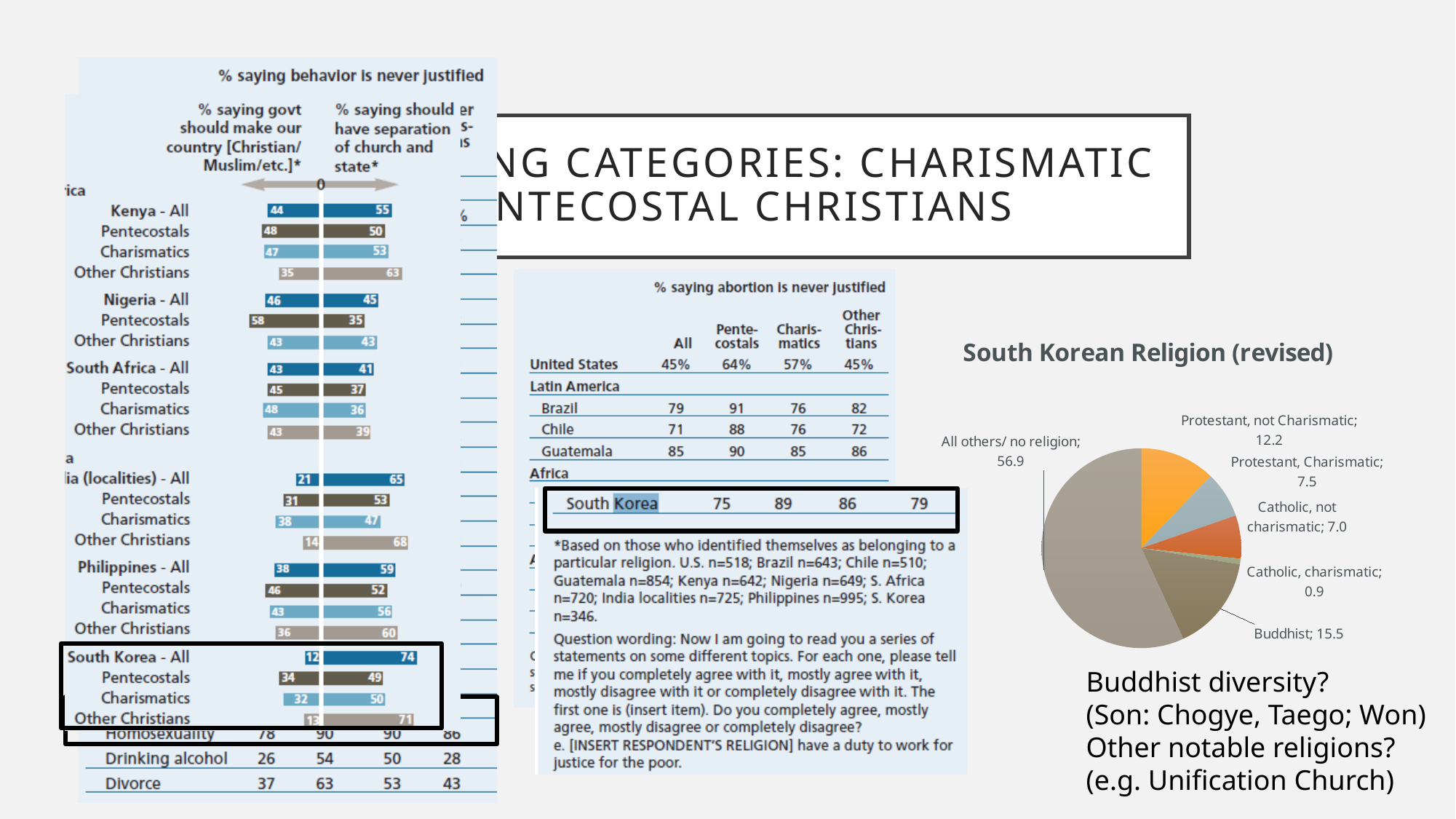
In the pie chart titled 'South Korean Religion (revised)', which category has the smallest slice? Catholic, charismatic In the pie chart titled 'South Korean Religion (revised)', which is larger: Buddhist or 'Protestant, not Charismatic'? Buddhist In the pie chart titled 'South Korean Religion (revised)', what is the value for 'Protestant, not Charismatic'? 12.2 In the bar chart on the left of the slide, what percentage of 'South Korea - All' say the government should make the country Christian/Muslim/etc.? 12 In the pie chart titled 'South Korean Religion (revised)', what is the difference between the values for 'Protestant, Charismatic' and 'Catholic, not charismatic'? 0.5 In the pie chart titled 'South Korean Religion (revised)', what is the value for Buddhist? 15.5 In the pie chart titled 'South Korean Religion (revised)', which category has the largest slice? All others/ no religion What kind of chart is the chart on the left of the slide showing '% saying govt should make our country' and '% saying should have separation of church and state'? bar chart In the bar chart on the left of the slide, what percentage of 'Kenya - All' say the government should make the country Christian/Muslim/etc.? 44 What kind of chart is the 'South Korean Religion (revised)' chart? pie chart In the bar chart on the left of the slide, what percentage of 'South Korea - All' say there should be separation of church and state? 74 In the pie chart titled 'South Korean Religion (revised)', how many categories are shown? 6